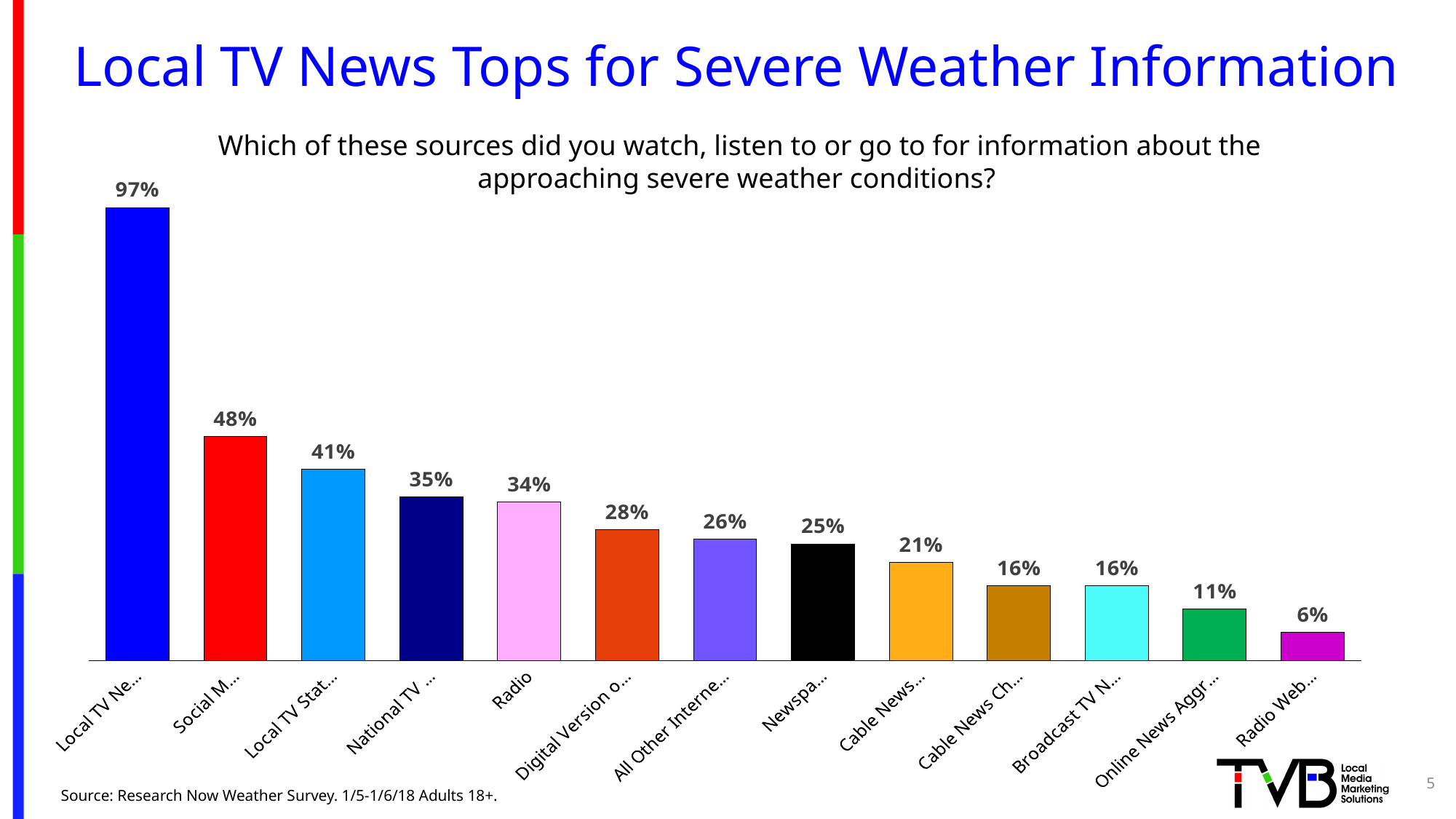
Which bar has the lowest value? the last bar on the right (Radio Web...) What is the difference between the first bar (97%) and the second bar (48%)? 49% What is the difference between Radio (34%) and the last bar (6%)? 28% What kind of chart is shown on the slide? bar chart What is the value shown for Radio? 34% What is the value of the second bar from the left (Social M...)? 48% Do the bar values rise or fall from left to right across the chart? fall How many bars (categories) are plotted in the chart? 13 Which is larger, the value for Radio or the value for the third bar (Local TV Stat...)? Local TV Stat... (41%) What is the value of the tallest bar, the first one on the left? 97% What is the title of the slide? Local TV News Tops for Severe Weather Information What is the value of the last bar on the right (Radio Web...)? 6%